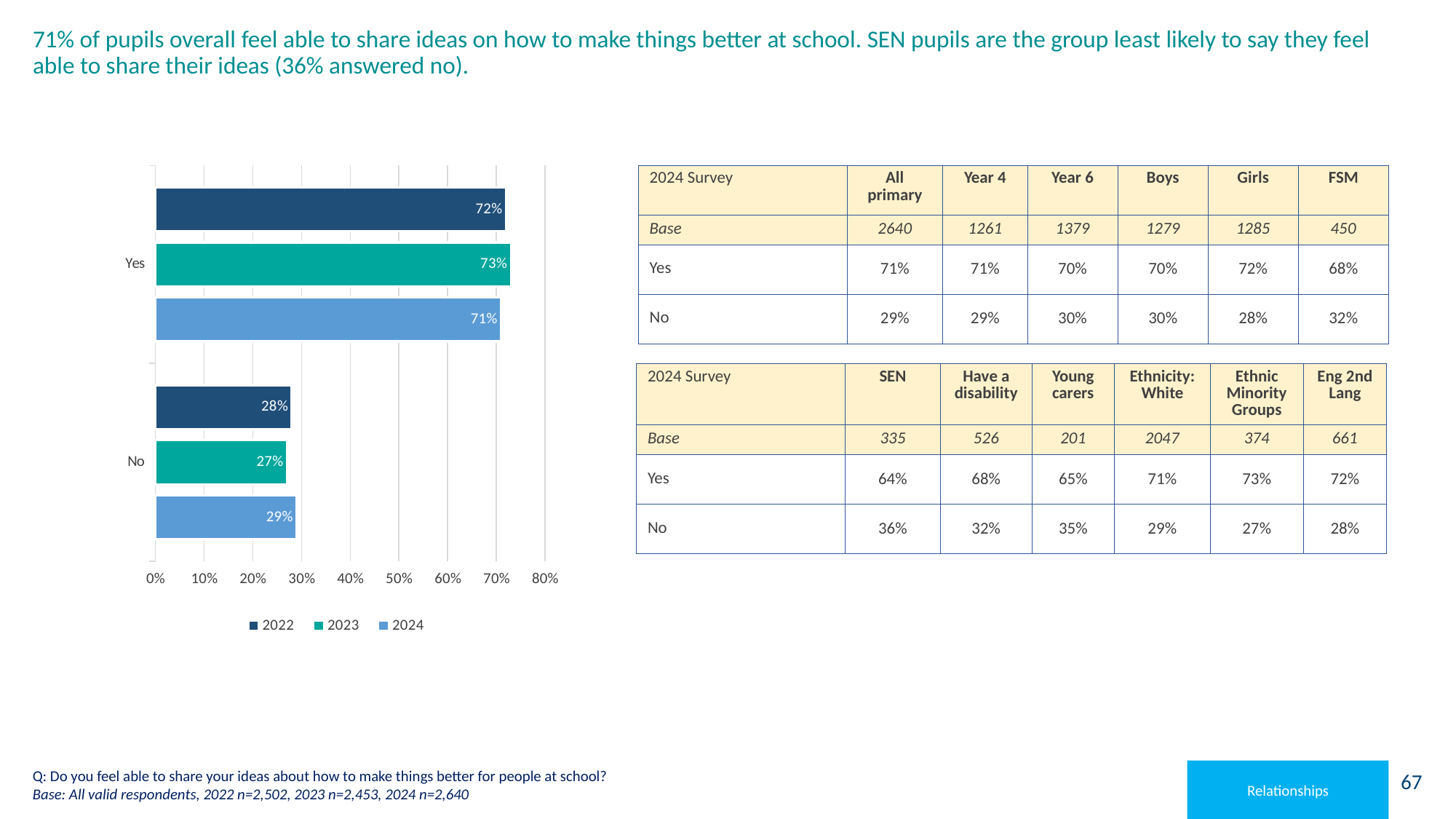
What is the difference between the Yes value in 2023 and the Yes value in 2024? 2% Is the value for Yes in 2024 greater or less than 60%? greater What kind of chart is shown on the slide? Bar chart How many series does the legend list? 3 How many categories are shown on the chart? 2 What is the value for Yes in 2023? 73% What is the value for Yes in 2022? 72% Which is larger, the No value in 2022 or the No value in 2024? 2024 What is the value for No in 2024? 29% Which year has the highest value for Yes? 2023 Which year has the lowest value for No? 2023 What is the value for No in 2023? 27%